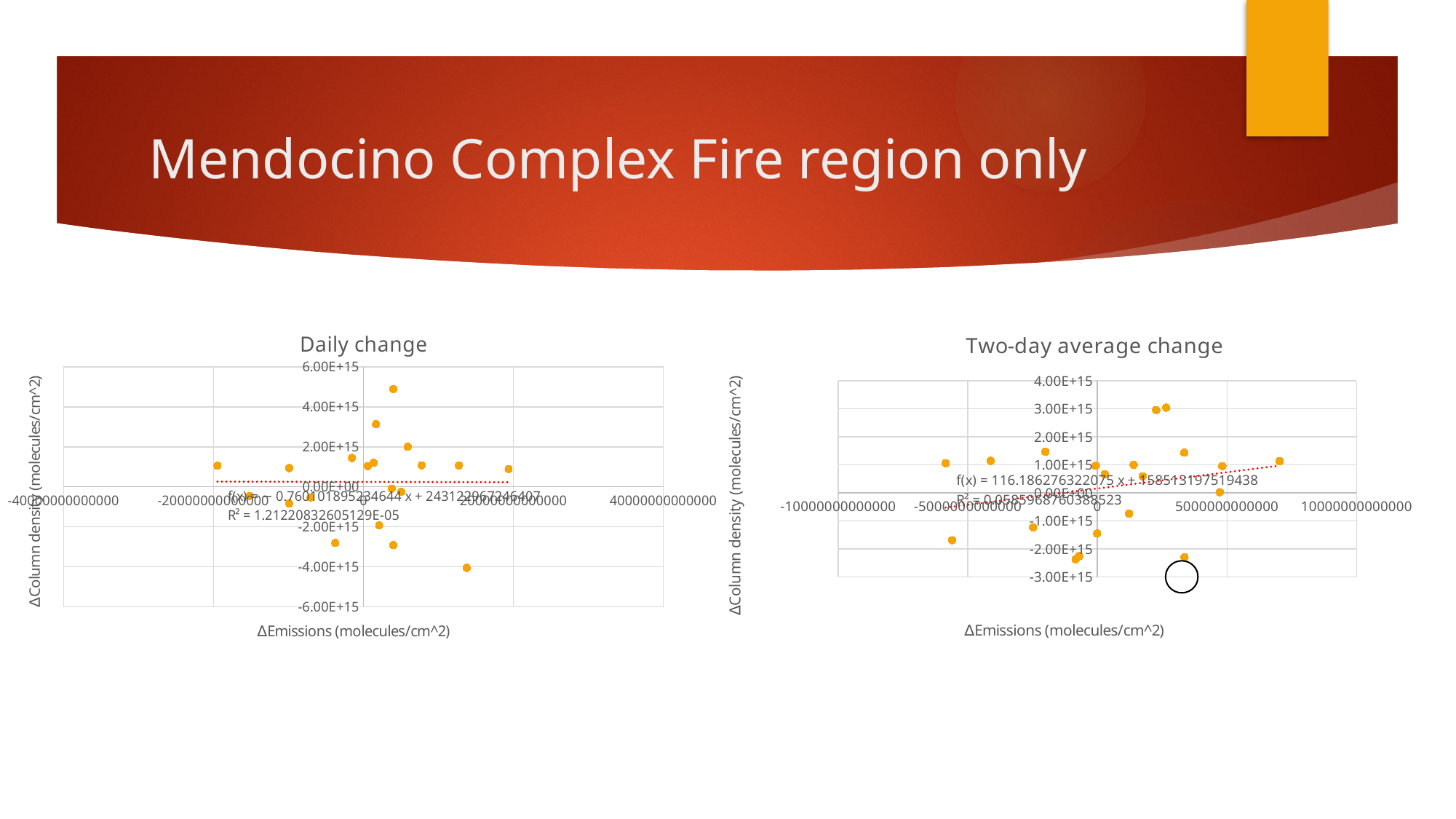
What is the title of the chart on the left side of the slide? Daily change What is the x-axis title of the 'Two-day average change' chart? ΔEmissions (molecules/cm^2) In the 'Two-day average change' chart, what is the highest value shown on the y-axis? 4.00E+15 What kind of chart is the 'Two-day average change' chart? scatter chart In the 'Daily change' chart, what R² value is printed for the trendline? R² = 1.21220832605129E-05 What kind of chart is the 'Daily change' chart? scatter chart In the 'Two-day average change' chart, is the highest plotted point greater or less than 2.00E+15? greater In the 'Daily change' chart, is the lowest plotted point greater or less than -2.00E+15? less In the 'Daily change' chart, is the highest plotted point greater or less than 4.00E+15? greater In the 'Two-day average change' chart, does the dotted trendline rise or fall from left to right? rise In the 'Two-day average change' chart, what is the lowest value shown on the y-axis? -3.00E+15 In the 'Daily change' chart, what is the highest value shown on the y-axis? 6.00E+15